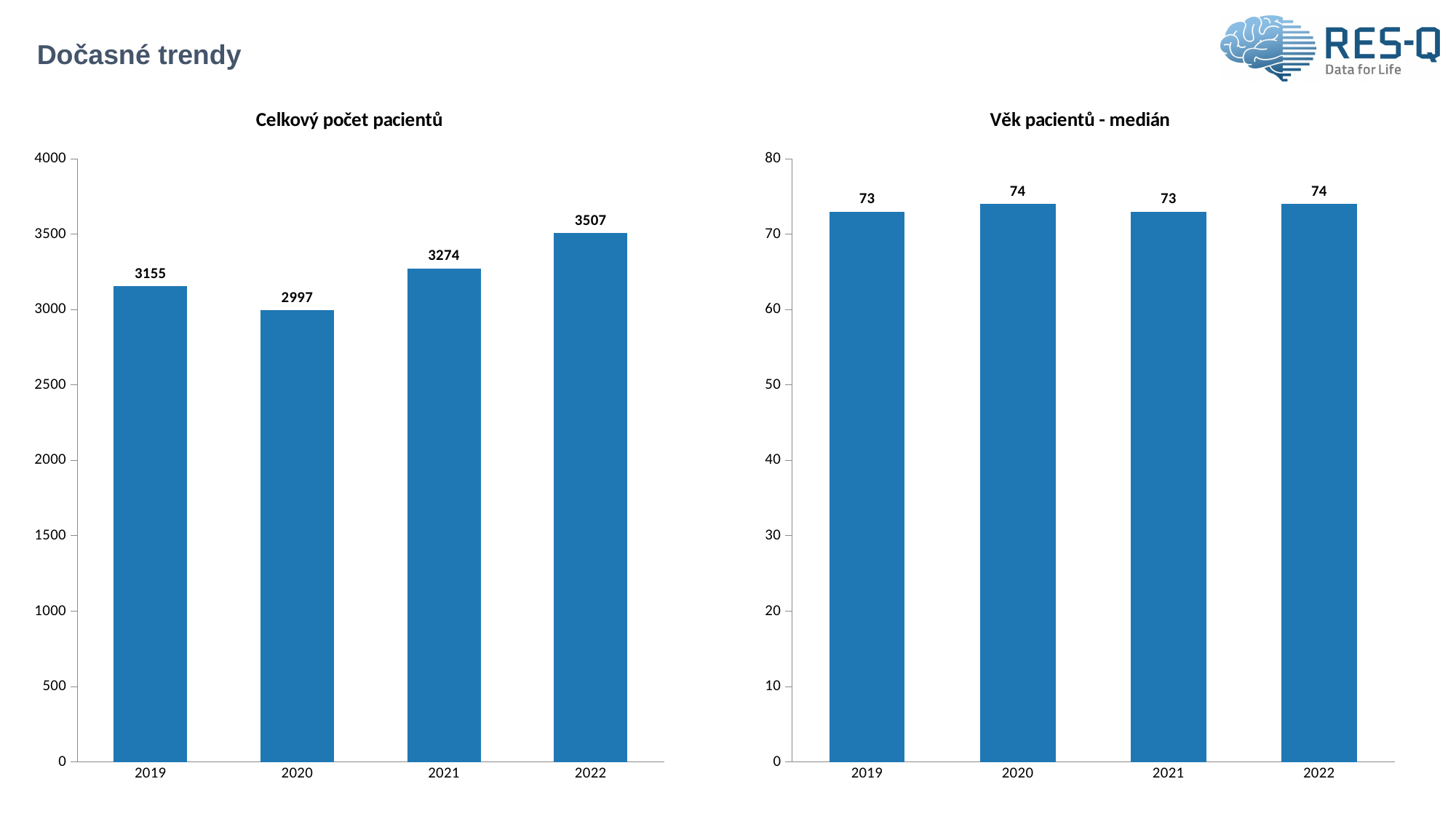
In the 'Celkový počet pacientů' chart, what is the difference between the values for 2022 and 2019? 352 In the 'Celkový počet pacientů' chart, what is the value for 2020? 2997 What kind of chart is the 'Věk pacientů - medián' chart? bar chart In the 'Celkový počet pacientů' chart, which year has the lowest value? 2020 In the 'Celkový počet pacientů' chart, which is larger, the value for 2019 or the value for 2021? 2021 In the 'Celkový počet pacientů' chart, what is the difference between the values for 2021 and 2020? 277 In the 'Věk pacientů - medián' chart, how many years are shown on the x axis? 4 In the 'Věk pacientů - medián' chart, what is the value for 2021? 73 In the 'Celkový počet pacientů' chart, which year has the highest value? 2022 In the 'Věk pacientů - medián' chart, what is the value for 2020? 74 In the 'Celkový počet pacientů' chart, what is the value for 2022? 3507 In the 'Celkový počet pacientů' chart, is the value for 2020 greater or less than 3000? less